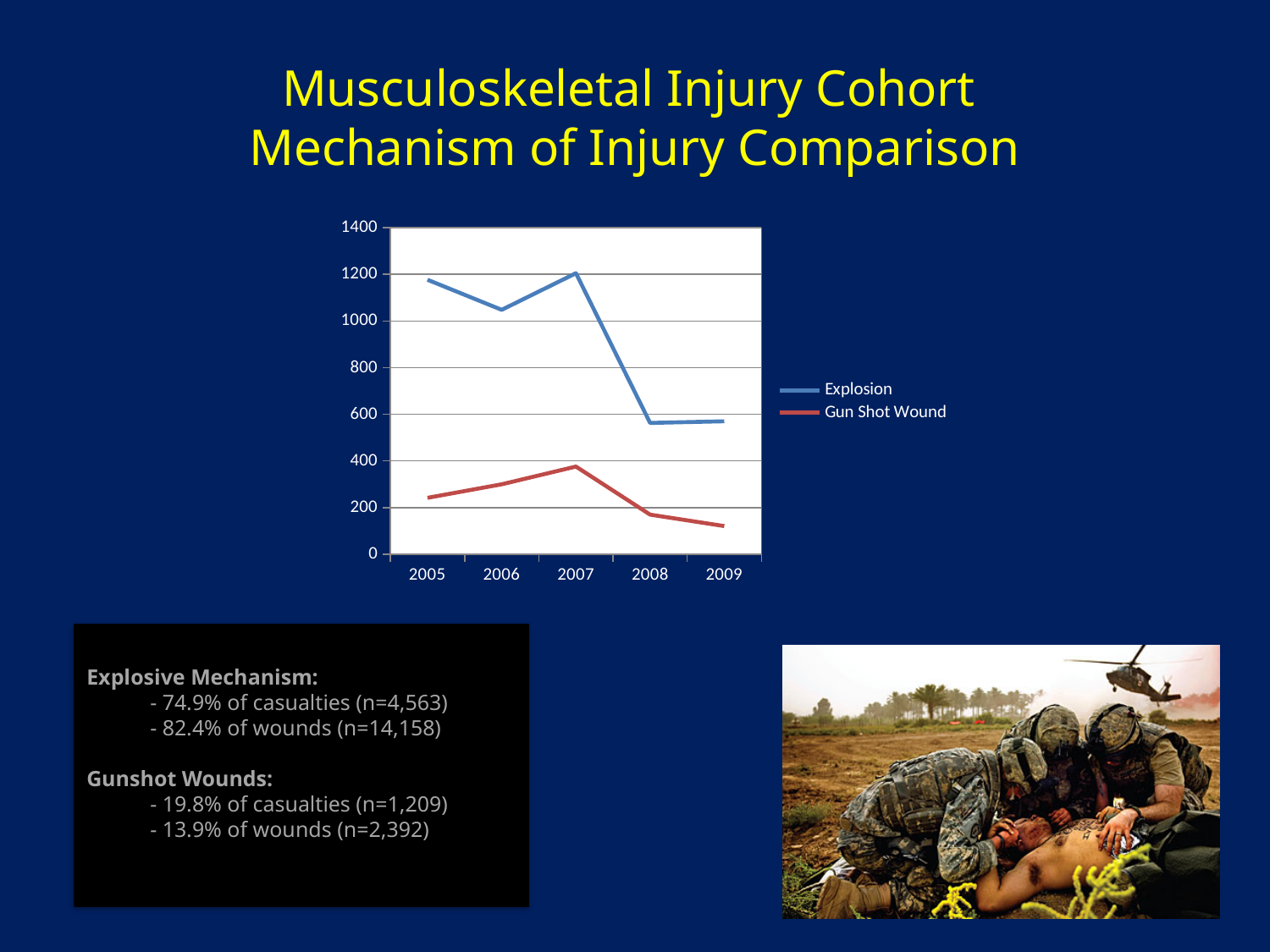
Is the value for Gun Shot Wound in 2009 greater or less than 200? less In 2007, which series has the larger value, Explosion or Gun Shot Wound? Explosion In which year does the Gun Shot Wound series reach its highest value? 2007 Which colour is used for the Explosion series in the chart? blue Is the value for Explosion in 2008 greater or less than 600? less What kind of chart is shown on the slide? line chart How many years are plotted along the x axis of the chart? 5 How many series does the chart legend list? 2 Is the value for Explosion in 2005 greater or less than 1000? greater In which year does the Gun Shot Wound series reach its lowest value? 2009 Does the Gun Shot Wound series rise or fall from 2007 to 2009? fall